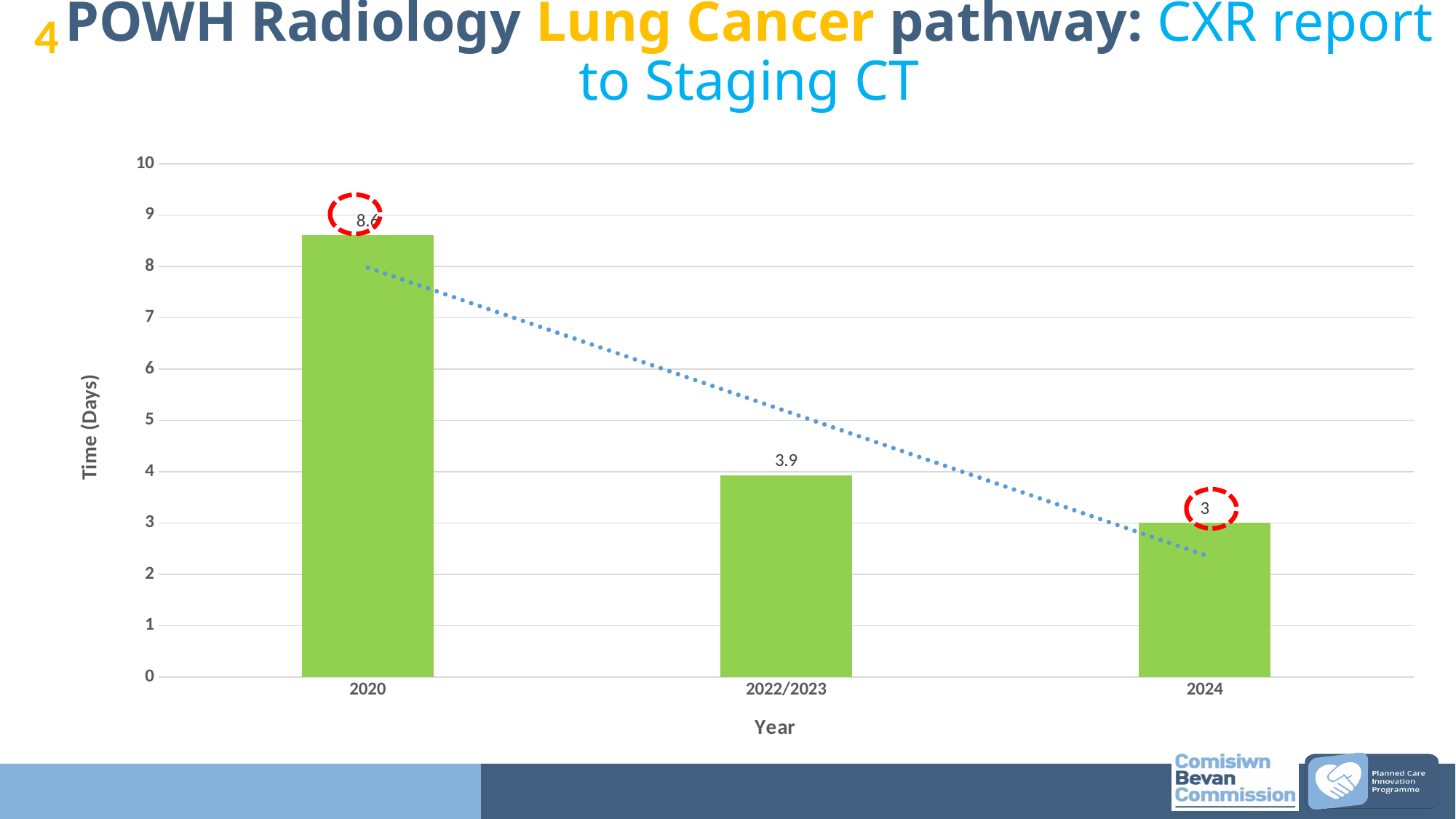
Do the values rise or fall from 2020 to 2024? fall What is the value for 2020? 8.6 How many years are shown on the x axis? 3 What kind of chart is shown on the slide? bar chart Is the value for 2020 greater or less than 8? greater What is the difference between the values for 2022/2023 and 2024? 0.9 Which year has the lowest value? 2024 What is the difference between the values for 2020 and 2024? 5.6 What is the value for 2024? 3 Which year has the highest value? 2020 Which is larger, the value for 2022/2023 or the value for 2024? 2022/2023 What is the value for 2022/2023? 3.9